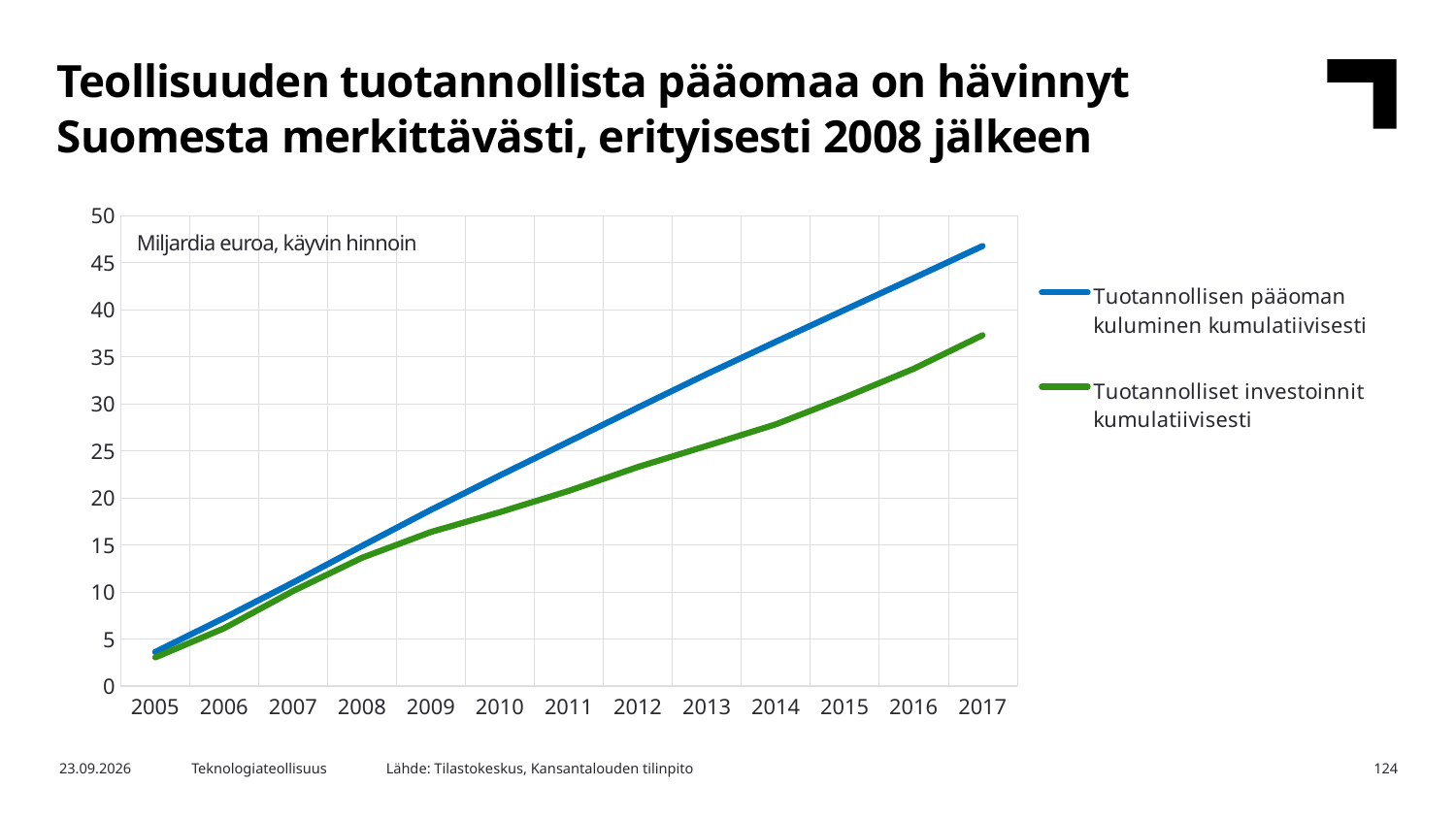
What kind of chart is shown on the slide? Line chart Is the value for 'Tuotannolliset investoinnit kumulatiivisesti' in 2014 greater or less than 30? less Which colour is used for the 'Tuotannolliset investoinnit kumulatiivisesti' line? Green How many series does the legend list? 2 Is the value for 'Tuotannollisen pääoman kuluminen kumulatiivisesti' in 2005 greater or less than 10? less Is the value for 'Tuotannollisen pääoman kuluminen kumulatiivisesti' in 2014 greater or less than 30? greater Do the values of the 'Tuotannollisen pääoman kuluminen kumulatiivisesti' series rise or fall from 2005 to 2017? Rise What unit is stated inside the chart area? Miljardia euroa, käyvin hinnoin How many years are shown on the x axis? 13 In 2017, which series has the higher value: 'Tuotannollisen pääoman kuluminen kumulatiivisesti' or 'Tuotannolliset investoinnit kumulatiivisesti'? Tuotannollisen pääoman kuluminen kumulatiivisesti